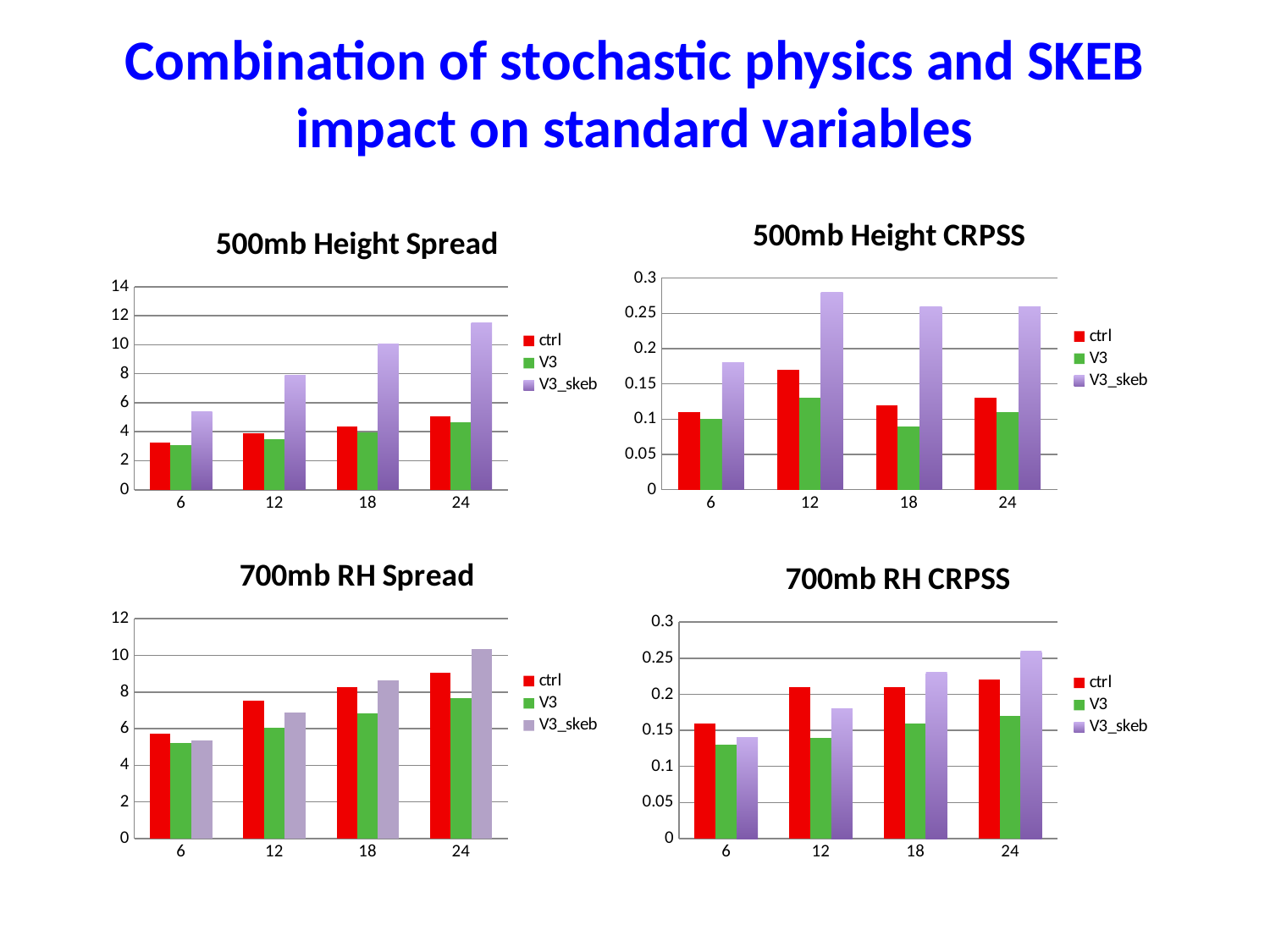
In the 700mb RH CRPSS chart, at which x-axis category is the V3 bar lowest? 6 In the 500mb Height CRPSS chart, is the value for V3_skeb at 12 greater or less than 0.25? greater How many series does the legend of the 700mb RH Spread chart list? 3 In the 500mb Height Spread chart, is the value for ctrl at 6 greater or less than 4? less In the 500mb Height Spread chart, do the V3_skeb values rise or fall as the x axis goes from 6 to 24? rise What kind of chart is the 500mb Height Spread chart? bar chart In the 700mb RH Spread chart, which is larger at 6: ctrl or V3? ctrl In the 500mb Height CRPSS chart, at which x-axis category is the V3_skeb bar highest? 12 In the 500mb Height Spread chart, is the value for V3_skeb at 24 greater or less than 10? greater